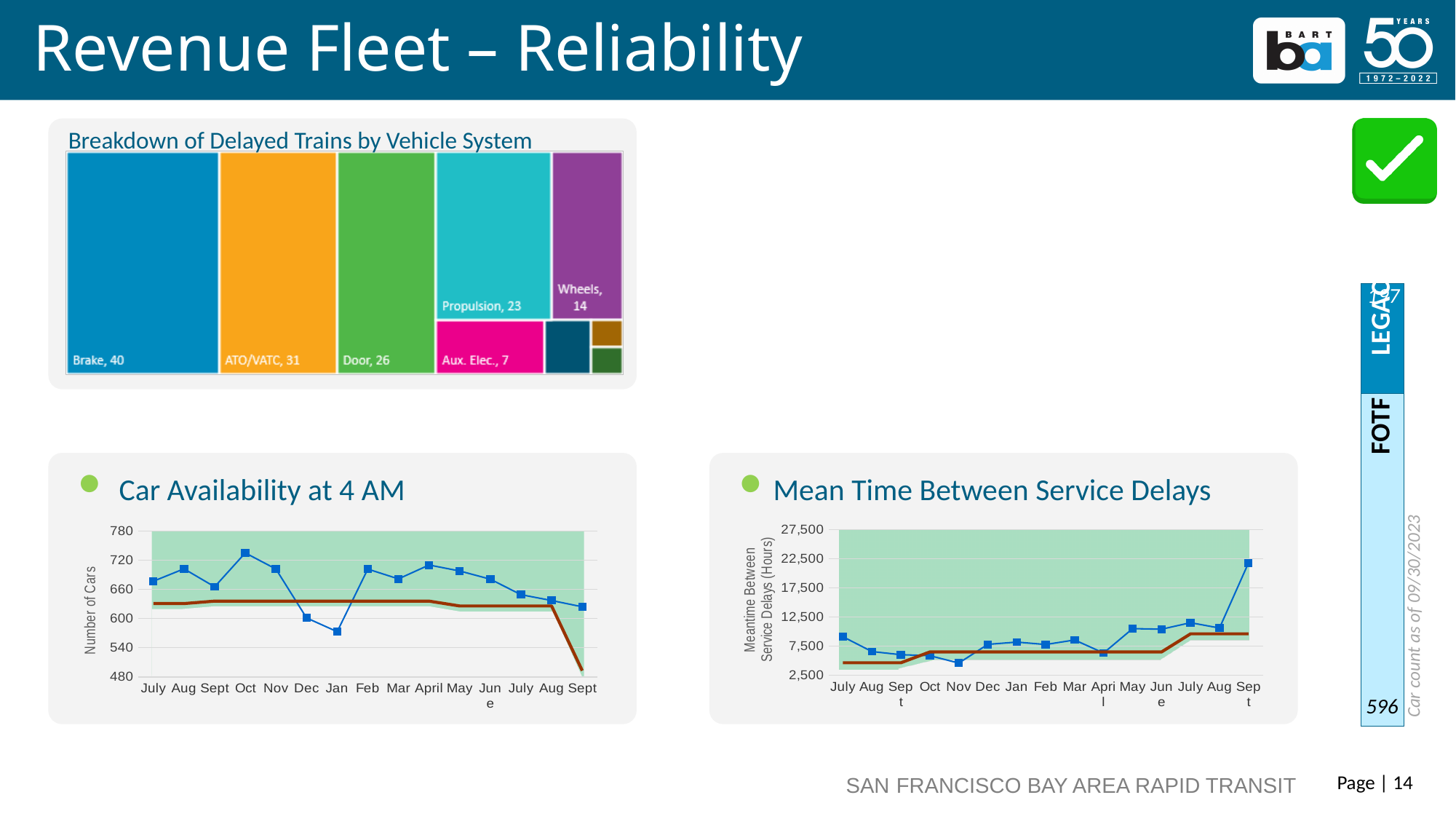
How many months are plotted along the x axis of the Car Availability at 4 AM chart? 15 In the Breakdown of Delayed Trains by Vehicle System chart, which vehicle system has the highest number of delayed trains? Brake In the Breakdown of Delayed Trains by Vehicle System chart, what is the value for Wheels? 14 In the Car Availability at 4 AM chart, is the value for Jan greater or less than 600? less In the Mean Time Between Service Delays chart, which month has the highest value? Sept (the last month) In the Breakdown of Delayed Trains by Vehicle System chart, what is the value for ATO/VATC? 31 In the Breakdown of Delayed Trains by Vehicle System chart, which is larger, Door or Propulsion? Door In the Breakdown of Delayed Trains by Vehicle System chart, what is the difference between the Brake and ATO/VATC values? 9 In the Car Availability at 4 AM chart, is the value for Oct greater or less than 720? greater In the Mean Time Between Service Delays chart, is the value for the final Sept greater or less than 17,500? greater In the Breakdown of Delayed Trains by Vehicle System chart, how many delayed trains are attributed to Brake? 40 What kind of chart is the Car Availability at 4 AM chart? line chart